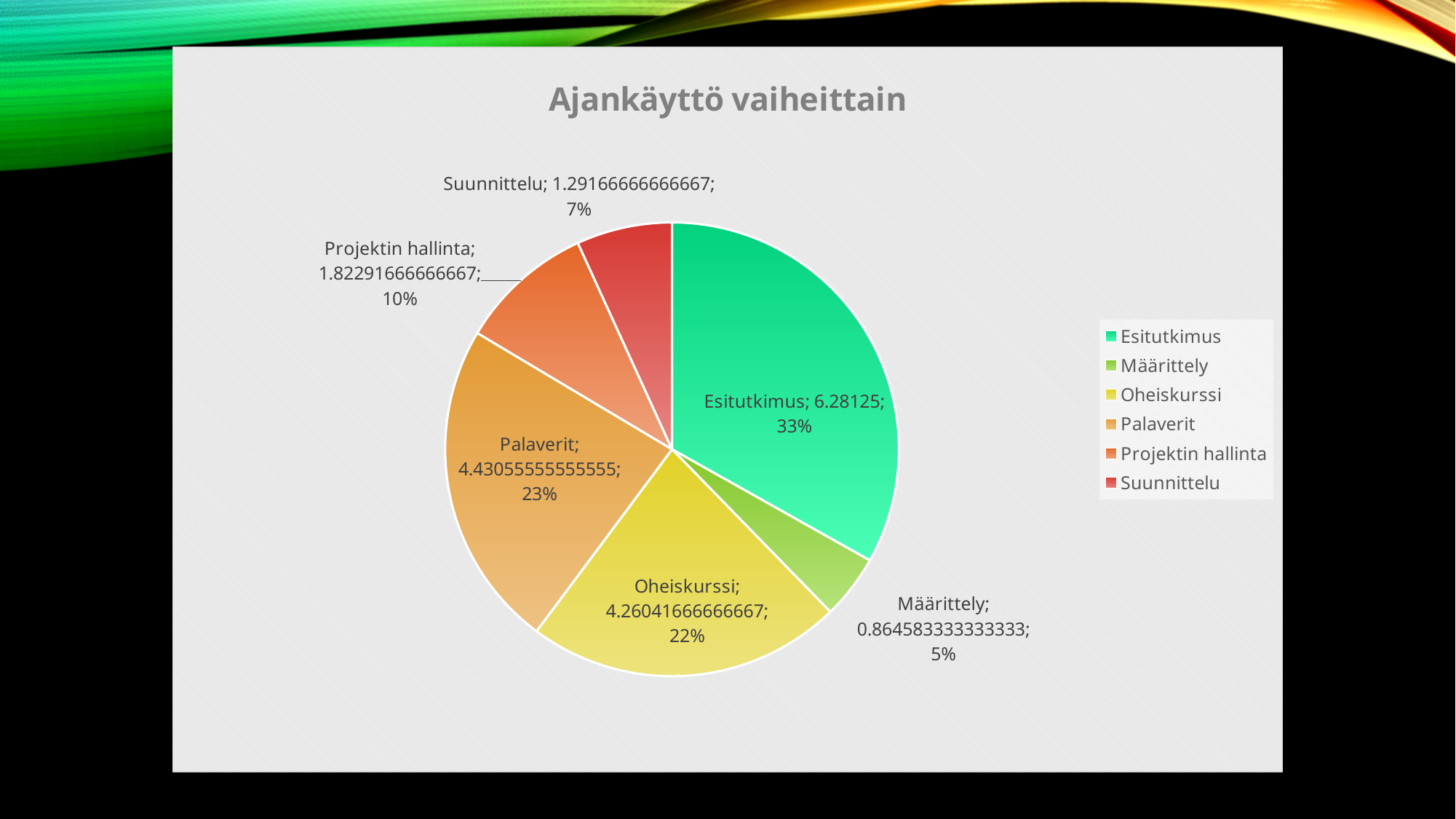
What value is shown for Esitutkimus? 6.28125 What is the title of the chart? Ajankäyttö vaiheittain What is the difference in percentage points between the Esitutkimus share and the Määrittely share? 28 percentage points How many entries does the legend list? 6 How many slices does the pie chart have? 6 What value is shown for Määrittely? 0.864583333333333 What percentage share does Projektin hallinta have? 10% Which is larger, the share for Palaverit or the share for Oheiskurssi? Palaverit Which category has the smallest slice? Määrittely Which category has the largest slice? Esitutkimus What type of chart is shown on the slide? pie chart What percentage share does Palaverit have? 23%